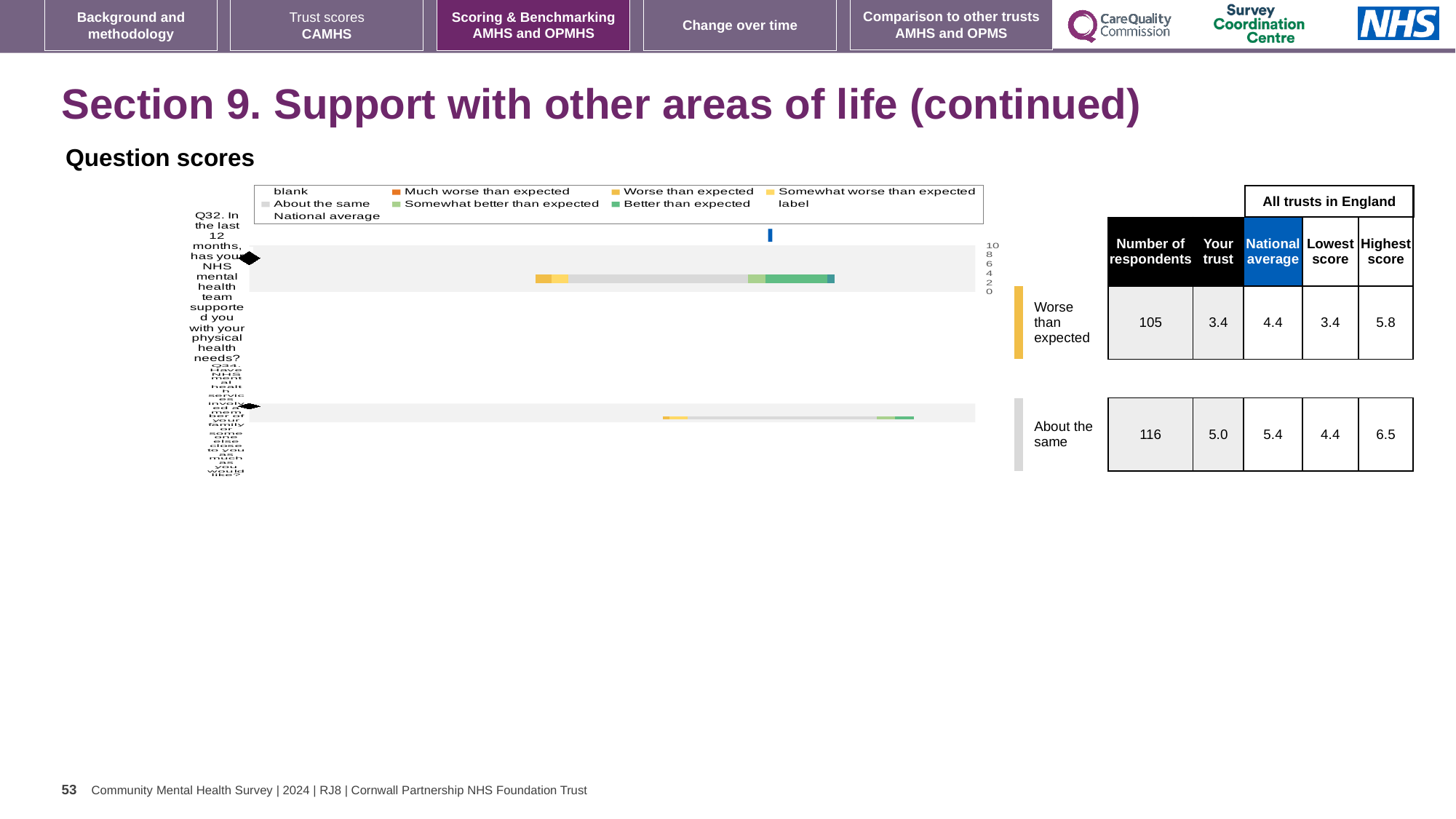
For Q32, which is larger: the 'Your trust' score or the national average? National average What is the difference between the highest and lowest scores for Q34? 2.1 What is the lowest score among all trusts in England for Q34? 4.4 How many respondents are shown for Q32 in the table? 105 What benchmark category is shown next to Q32? Worse than expected How many questions are plotted in the chart? 2 What is the 'Your trust' score for Q32? 3.4 What is the difference between the national average and the 'Your trust' score for Q32? 1.0 What is the national average for Q34? 5.4 What kind of chart is shown on the slide? Bar chart Which question has the larger number of respondents, Q32 or Q34? Q34 What is the highest score among all trusts in England for Q32? 5.8